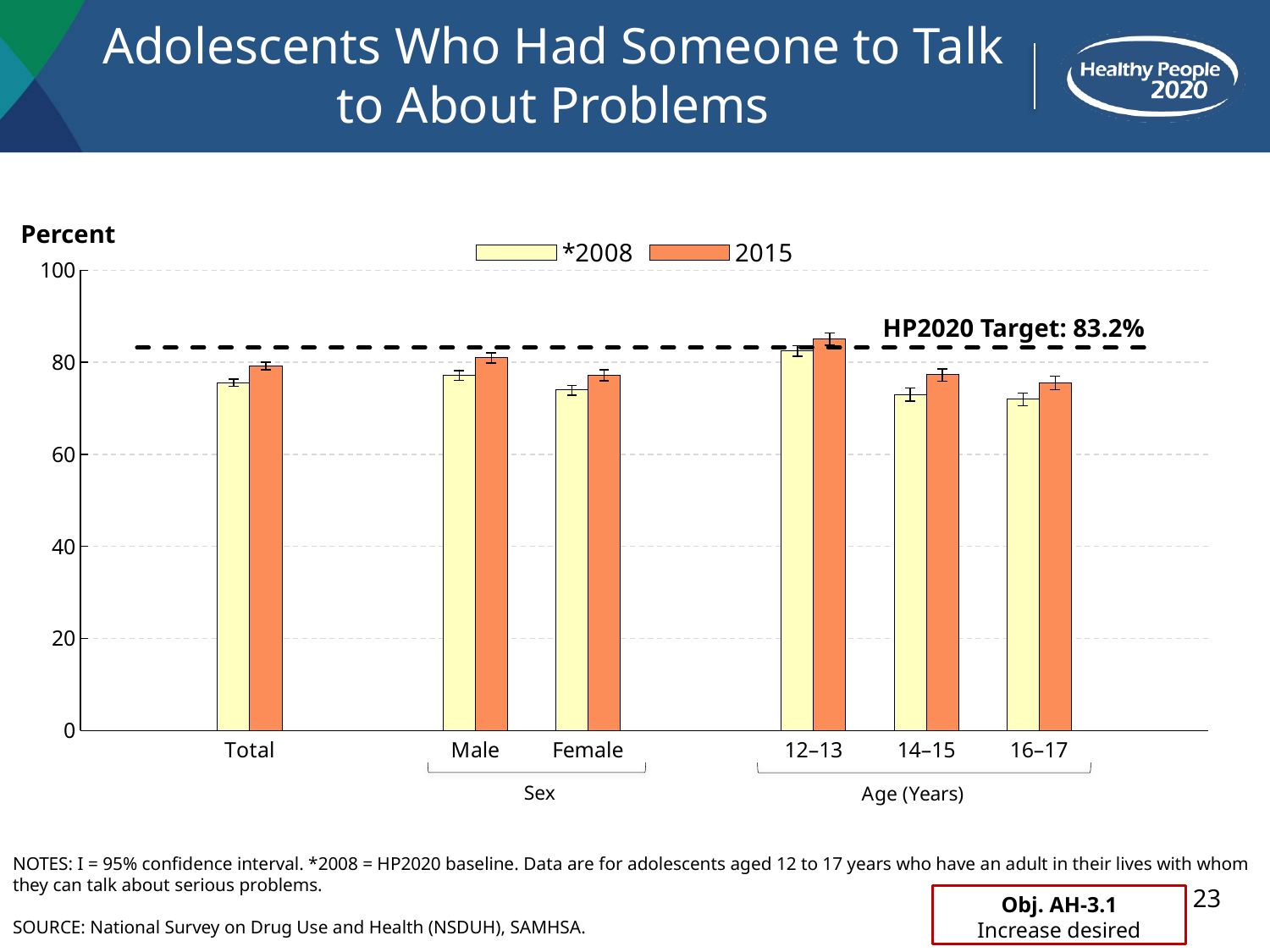
What are the two series named in the legend? *2008 and 2015 For the Total category, which is larger, the 2008 value or the 2015 value? 2015 Do the 2015 values rise or fall across the age groups from 12–13 to 16–17? Fall Which is larger in 2015, the value for Male or the value for Female? Male Is the 2015 value for 12–13 greater or less than 80? greater What kind of chart is shown on the slide? Bar chart How many categories are shown along the x axis? 6 Which category has the highest 2015 value? 12–13 Is the 2008 value for Total greater or less than 80? less How many series does the legend list? 2 Is the 2008 value for Female greater or less than 80? less What is the HP2020 Target value shown on the chart? 83.2%